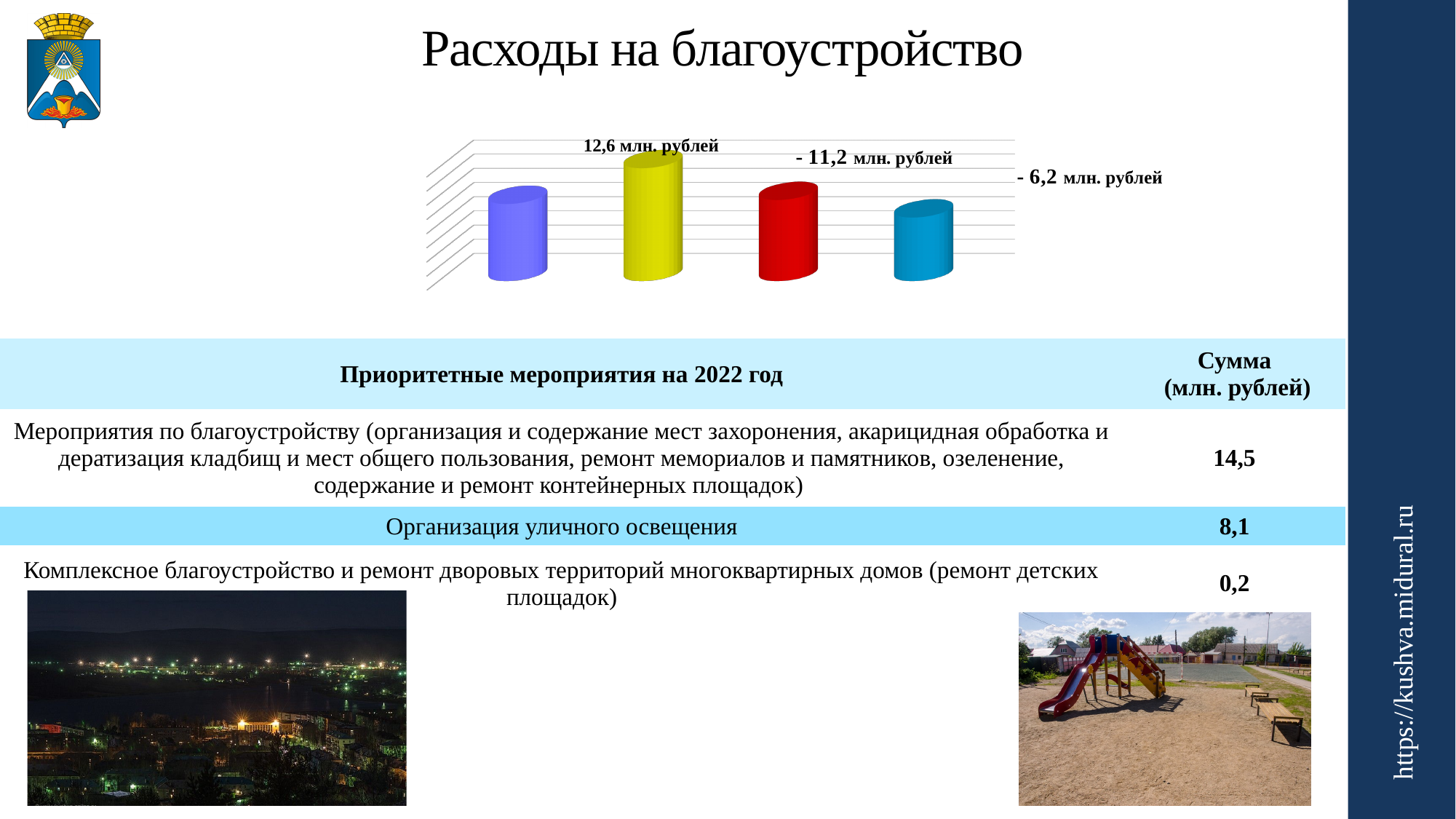
Which bar is the shortest in the chart? the blue bar What value is labelled on the red bar? - 11,2 млн. рублей What value is labelled on the blue bar? - 6,2 млн. рублей Which bar is the tallest in the chart? the yellow bar Which is larger, the value of the yellow bar or the value of the blue bar? the yellow bar How many bars are plotted in the chart? 4 What is the title of the slide containing the chart? Расходы на благоустройство What value is labelled on the yellow bar? 12,6 млн. рублей Going from the yellow bar to the blue bar on the right, do the values rise or fall? fall What kind of chart is shown on the slide? bar chart